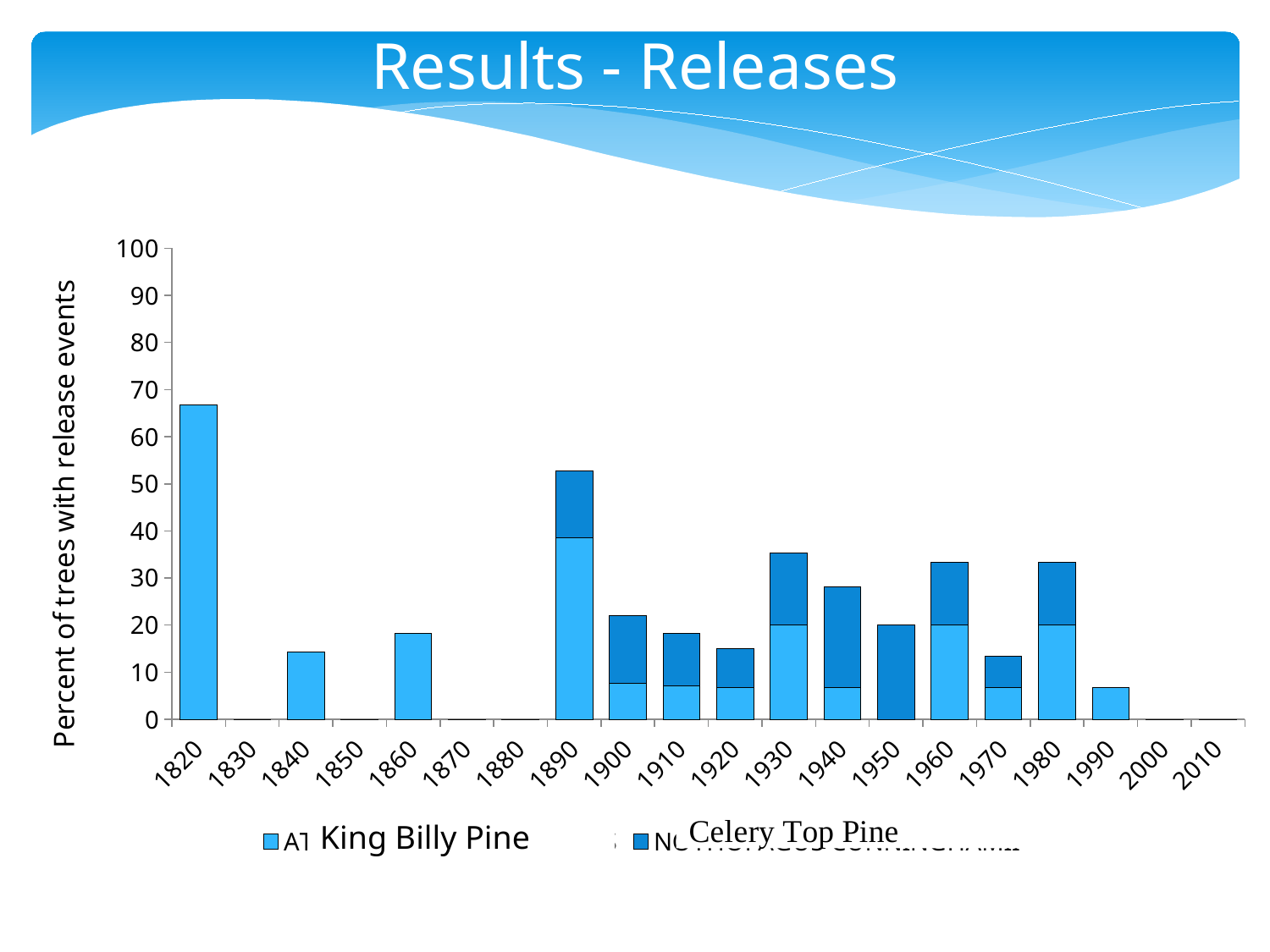
How many series does the legend list? 2 Which decade has the larger total bar, 1820 or 1890? 1820 Is the total value for 1890 greater or less than 40? greater Is the total value for 1820 greater or less than 60? greater Which decade has the highest total percent of trees with release events? 1820 Is the value for 1840 greater or less than 20? less Which decade has the larger total bar, 1930 or 1970? 1930 Which two species are named in the legend? King Billy Pine and Celery Top Pine How many decade categories are shown on the x axis? 20 What is the title of the y axis? Percent of trees with release events What kind of chart is shown on the slide? bar chart